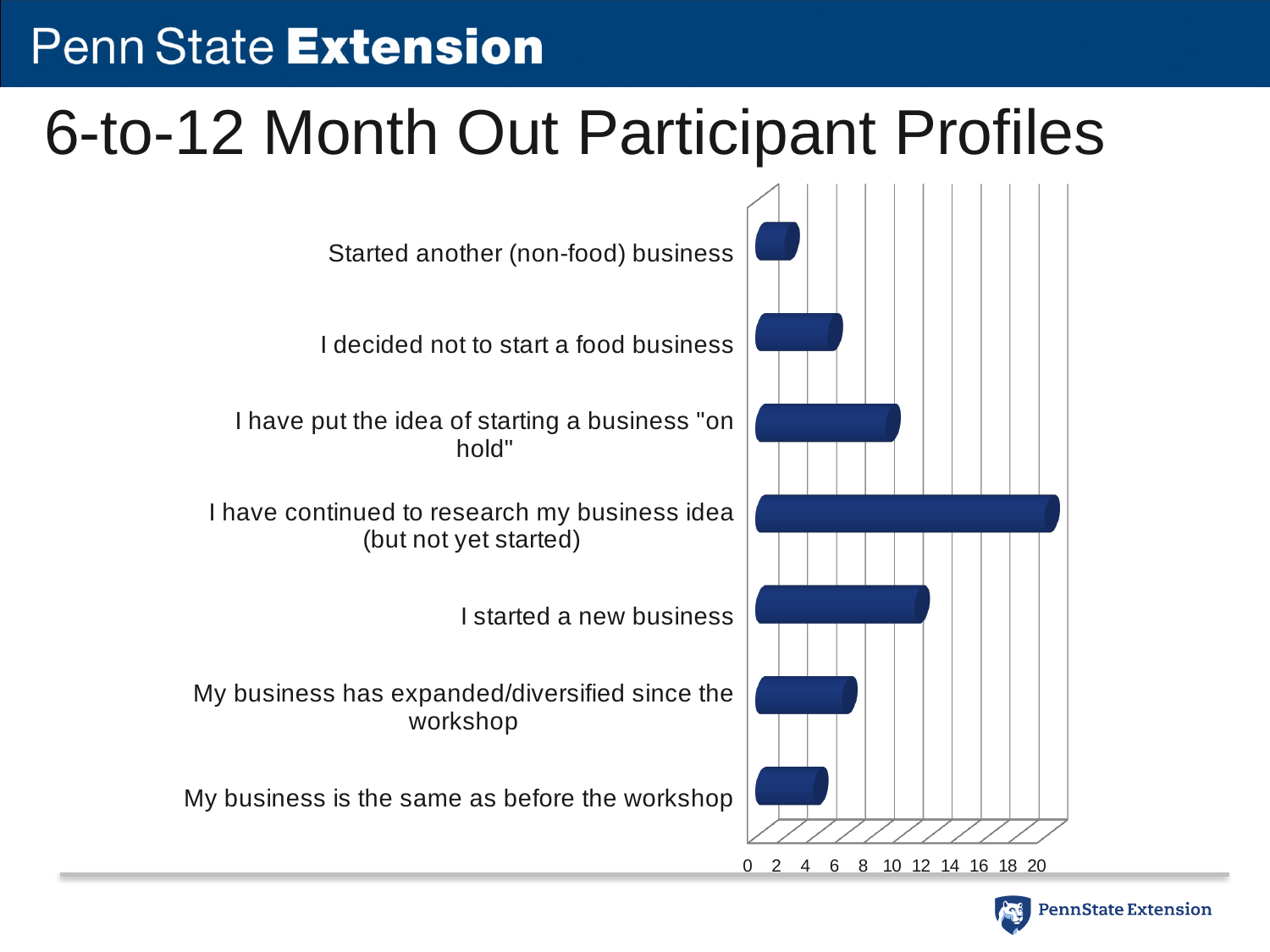
Which is larger: the value for "I have continued to research my business idea (but not yet started)" or the value for "I started a new business"? I have continued to research my business idea (but not yet started) How many categories are plotted in the chart? 7 Is the value for "I have put the idea of starting a business "on hold"" greater or less than 8? greater Which category has the lowest value? Started another (non-food) business Which category has the highest value? I have continued to research my business idea (but not yet started) Which is larger: the value for "I have put the idea of starting a business "on hold"" or the value for "My business is the same as before the workshop"? I have put the idea of starting a business "on hold" What is the title of the slide containing the chart? 6-to-12 Month Out Participant Profiles Is the value for "I started a new business" greater or less than 8? greater What kind of chart is shown on the slide? Bar chart Is the value for "I have continued to research my business idea (but not yet started)" greater or less than 18? greater